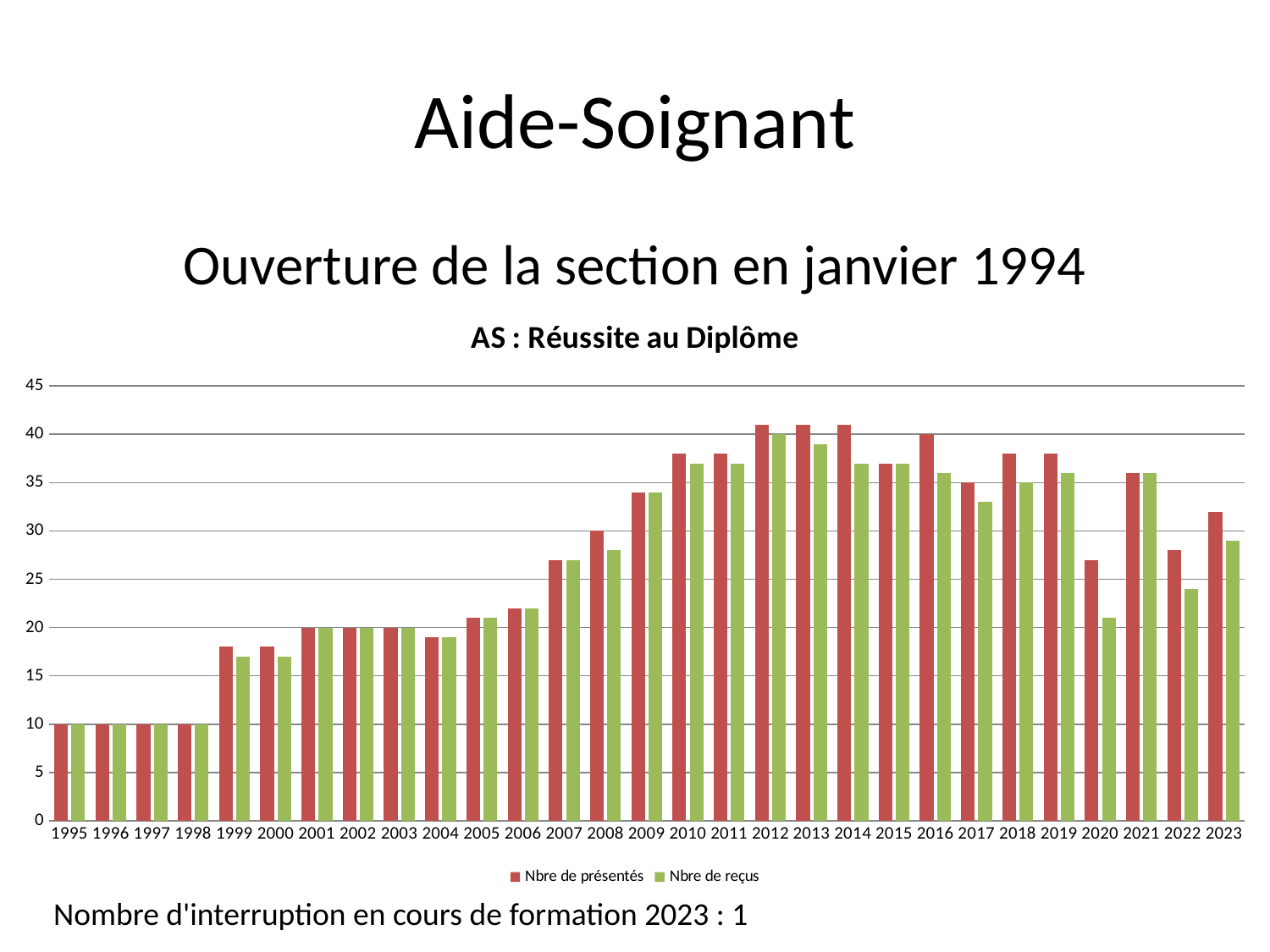
Which is larger in 2020, Nbre de présentés or Nbre de reçus? Nbre de présentés What is the value of Nbre de présentés for 2016? 40 How many years are shown on the x axis? 29 What kind of chart is shown on the slide? bar chart What is the value of Nbre de reçus for 2001? 20 What are the two series named in the legend? Nbre de présentés, Nbre de reçus How many series does the legend list? 2 What is the title of the chart? AS : Réussite au Diplôme Is the value of Nbre de reçus for 2020 greater or less than 25? less What is the value of Nbre de reçus for 2018? 35 What is the value of Nbre de présentés for 1995? 10 Do the Nbre de présentés values rise or fall from 1995 to 2012? rise